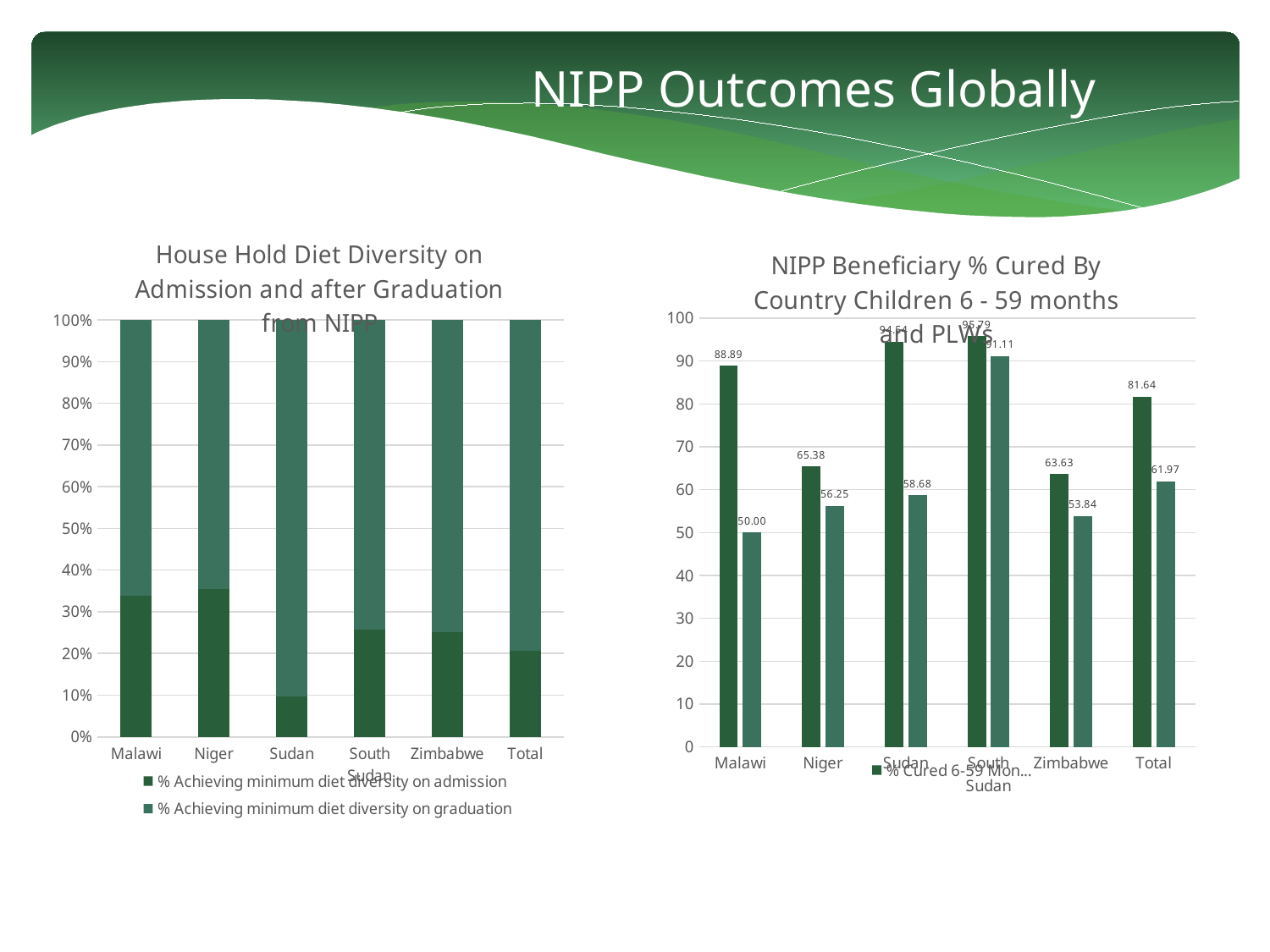
In the right chart, 'NIPP Beneficiary % Cured By Country', what is the value of the first (darker) bar for Zimbabwe? 63.63 In the right chart, 'NIPP Beneficiary % Cured By Country', what is the value of the first (darker) bar for Malawi? 88.89 In the right chart, 'NIPP Beneficiary % Cured By Country', which is larger: the first (darker) bar for Niger or the first (darker) bar for Zimbabwe? Niger In the left chart, 'House Hold Diet Diversity', how many countries/categories are shown on the x axis? 6 In the right chart, 'NIPP Beneficiary % Cured By Country', how many countries/categories are shown on the x axis? 6 In the right chart, 'NIPP Beneficiary % Cured By Country', what is the value of the second (lighter) bar for Total? 61.97 In the right chart, 'NIPP Beneficiary % Cured By Country', which country has the lowest value for the second (lighter) bar? Malawi In the left chart, 'House Hold Diet Diversity', how many series does the legend list? 2 In the left chart, 'House Hold Diet Diversity', is the value for Malawi '% Achieving minimum diet diversity on admission' greater or less than 30%? greater In the left chart, 'House Hold Diet Diversity', is the value for Sudan '% Achieving minimum diet diversity on admission' greater or less than 20%? less In the right chart, 'NIPP Beneficiary % Cured By Country', what is the difference between the two bars for Malawi? 38.89 What kind of chart is the left chart, 'House Hold Diet Diversity on Admission and after Graduation from NIPP'? Stacked bar chart